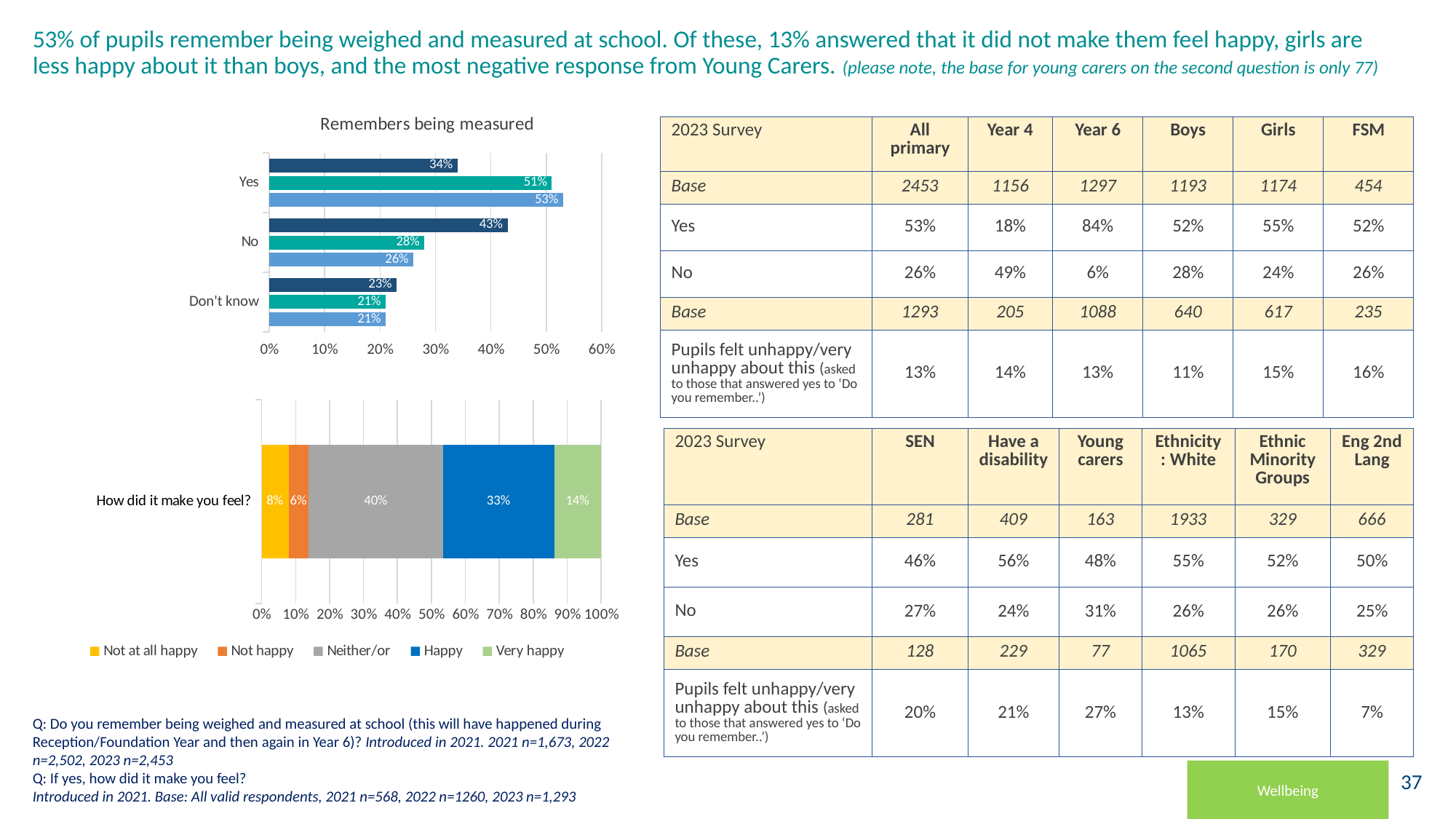
In the 'Remembers being measured' chart, which is larger for 'No': the dark blue bar or the teal bar? dark blue bar What kind of chart is 'Remembers being measured'? bar chart How many series does the legend of the 'How did it make you feel?' chart list? 5 In the 'How did it make you feel?' chart, what percentage answered 'Neither/or'? 40% In the 'How did it make you feel?' chart, what is the combined percentage of 'Not at all happy' and 'Not happy'? 14% In the 'Remembers being measured' chart, what is the difference between the light blue bar for 'Yes' and the light blue bar for 'No'? 27% In the 'How did it make you feel?' chart, which response has the smallest share? Not happy In the 'Remembers being measured' chart, what is the value of the teal bar for 'Don't know'? 21% In the 'Remembers being measured' chart, what is the value of the light blue bar for 'Yes'? 53% In the 'How did it make you feel?' chart, what percentage answered 'Very happy'? 14% In the 'Remembers being measured' chart, what is the value of the dark blue bar for 'No'? 43% In the 'Remembers being measured' chart, how many categories are shown on the vertical axis? 3